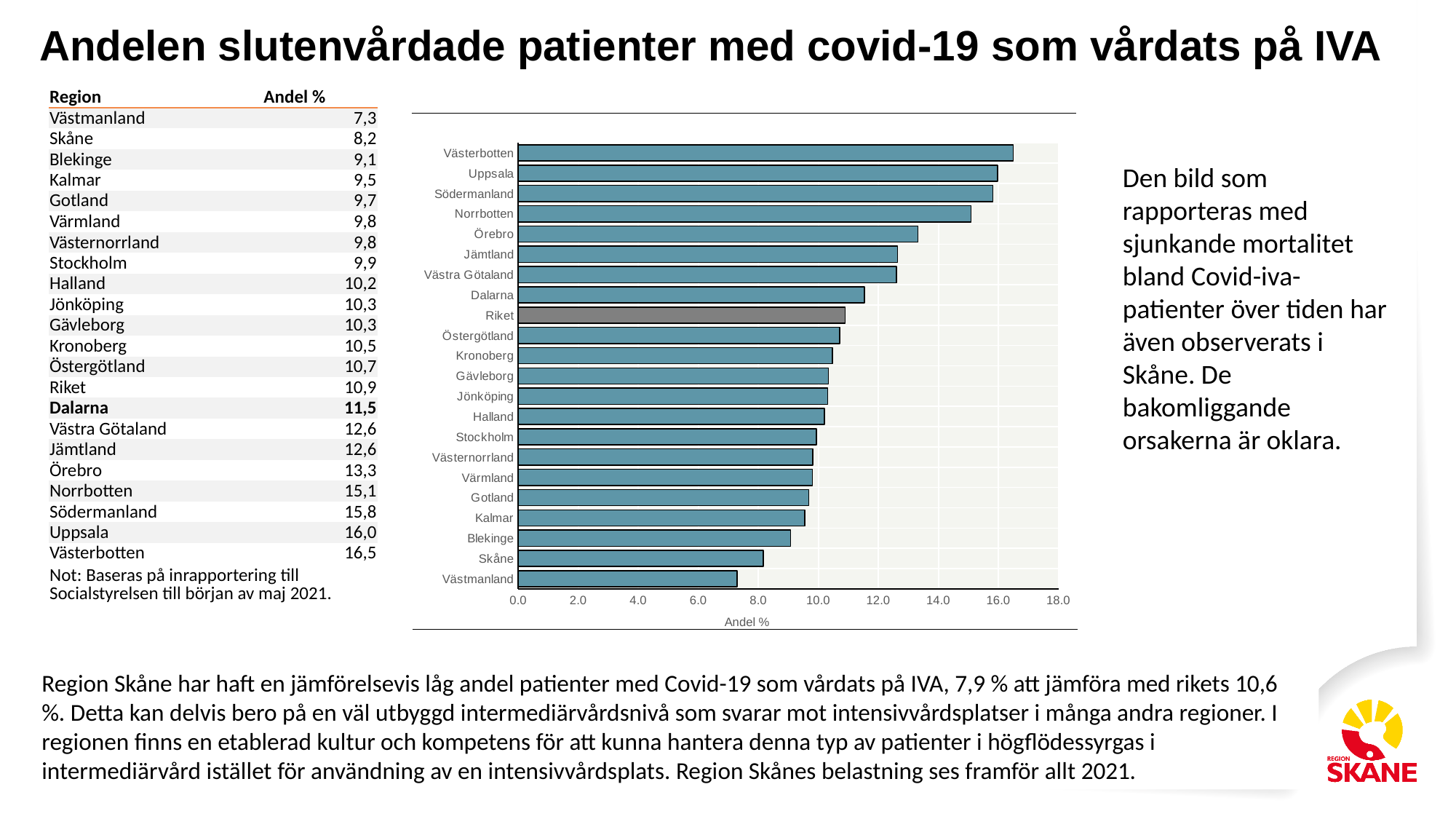
How many bars are plotted in the chart? 22 What is the difference between the values for Uppsala and Västmanland? 8,7 Is the value for Blekinge greater or less than 10.0? less Is the value for Norrbotten greater or less than 14.0? greater What is the value (Andel %) for Västerbotten? 16,5 What is the value (Andel %) for Riket? 10,9 Which region has the highest share (Andel %) in the bar chart? Västerbotten What is the value (Andel %) for Skåne? 8,2 Which region has the lowest share (Andel %) in the bar chart? Västmanland What kind of chart is shown on the slide? bar chart Which is larger, the value for Örebro or the value for Dalarna? Örebro What is the label of the horizontal axis of the chart? Andel %